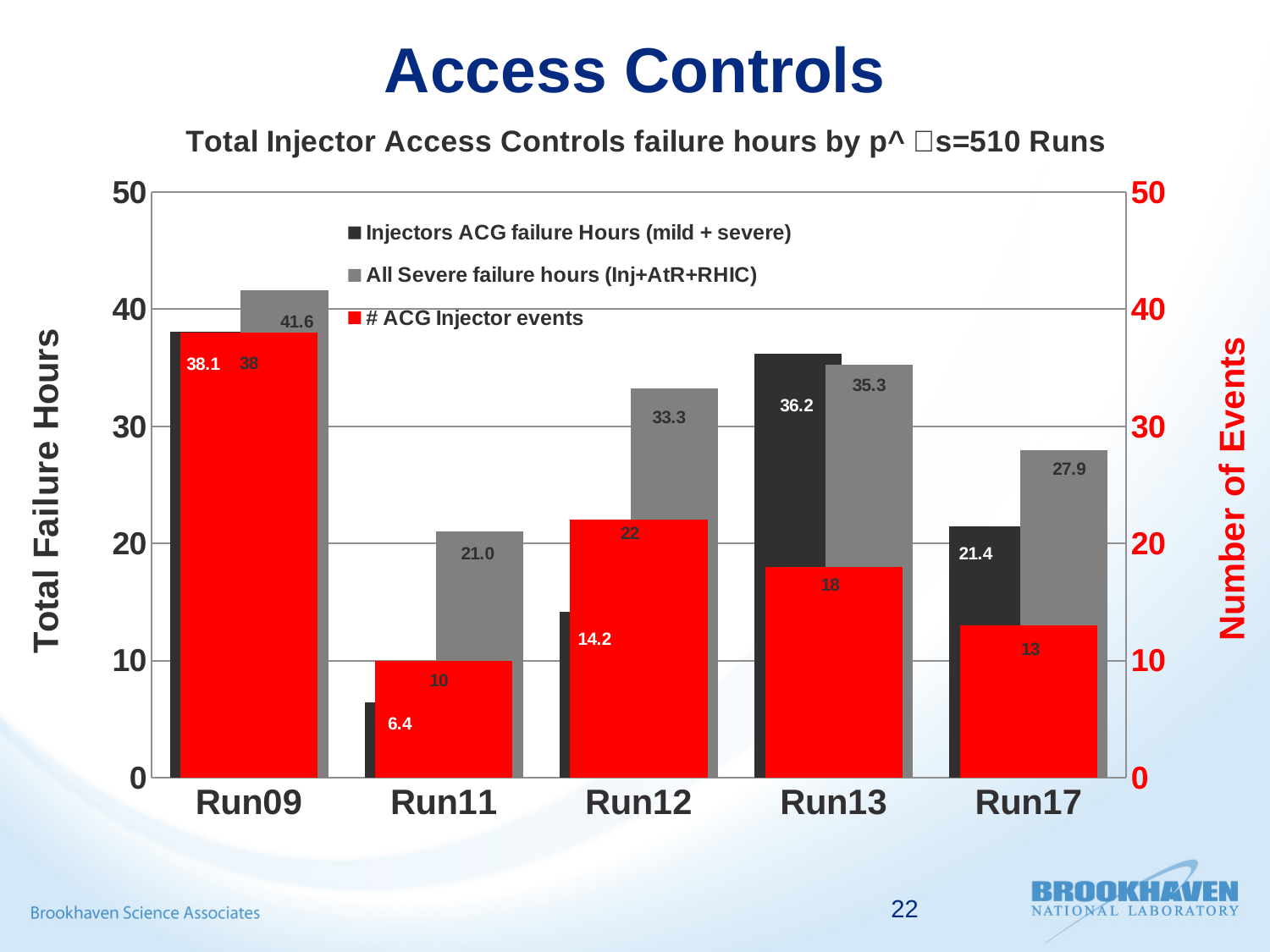
How many series does the legend list? 3 How many # ACG Injector events are shown for Run11? 10 What is the value of Injectors ACG failure Hours (mild + severe) for Run13? 36.2 Which run has the lowest Injectors ACG failure Hours (mild + severe)? Run11 Which is larger for Run13: the # ACG Injector events or the # ACG Injector events for Run12? Run12 What kind of chart is shown on the slide? bar chart What is the label of the right-hand vertical axis? Number of Events How many runs are shown on the x axis? 5 What is the difference between the All Severe failure hours and the Injectors ACG failure Hours for Run17? 6.5 Is the Injectors ACG failure Hours value for Run12 greater or less than 20? less What is the value of All Severe failure hours (Inj+AtR+RHIC) for Run12? 33.3 Which run has the highest All Severe failure hours (Inj+AtR+RHIC)? Run09